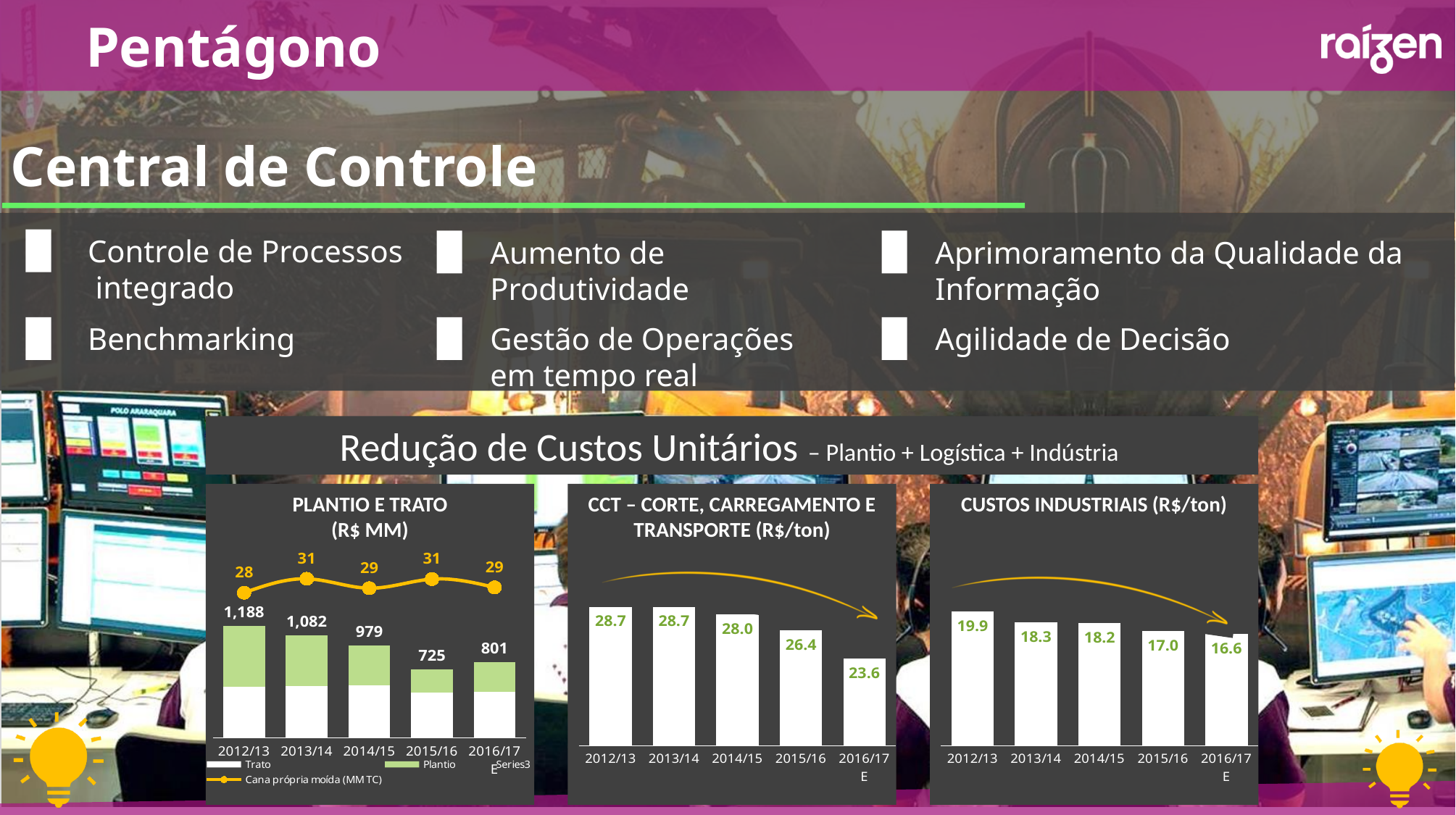
In the CCT – Corte, Carregamento e Transporte (R$/ton) chart, which year has the lowest value? 2016/17 E What kind of chart is the Custos Industriais (R$/ton) chart? bar chart In the Plantio e Trato (R$ MM) chart, what is the value of the Cana própria moída (MM TC) line for 2013/14? 31 In the Custos Industriais (R$/ton) chart, what is the value for 2012/13? 19.9 In the Custos Industriais (R$/ton) chart, what is the difference between the 2012/13 value and the 2016/17 E value? 3.3 In the Custos Industriais (R$/ton) chart, do the values rise or fall from 2012/13 to 2016/17 E? fall In the Plantio e Trato (R$ MM) chart, what is the total labelled above the bar for 2014/15? 979 In the CCT – Corte, Carregamento e Transporte (R$/ton) chart, by how much does the value fall from 2012/13 to 2016/17 E? 5.1 In the Plantio e Trato (R$ MM) chart, which year has the highest bar total? 2012/13 How many bars are shown in the CCT – Corte, Carregamento e Transporte (R$/ton) chart? 5 In the CCT – Corte, Carregamento e Transporte (R$/ton) chart, what is the value for 2015/16? 26.4 In the Plantio e Trato (R$ MM) chart, which bar total is larger, 2015/16 or 2016/17 E? 2016/17 E